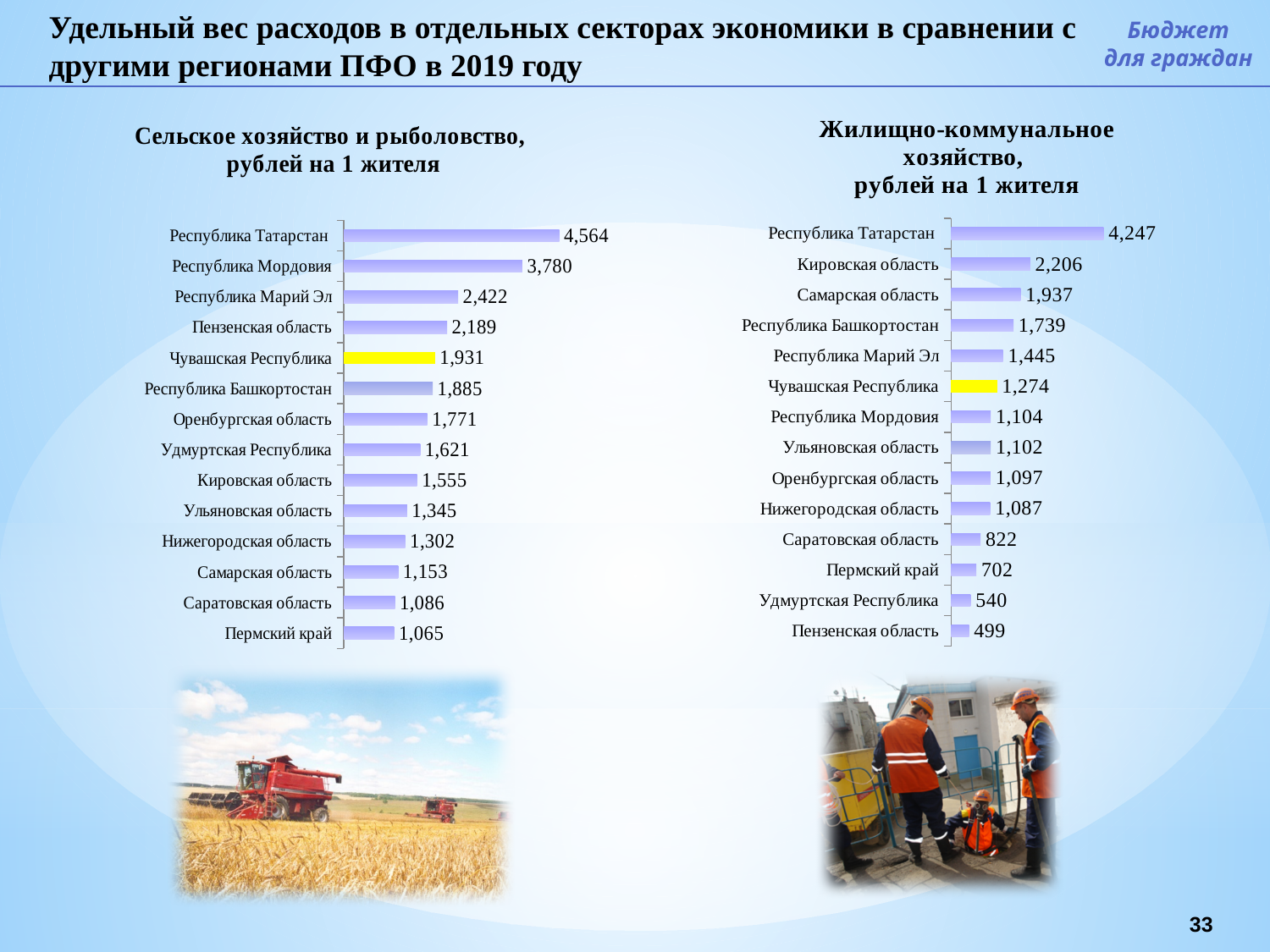
In the chart 'Сельское хозяйство и рыболовство, рублей на 1 жителя', which region has the lowest value? Пермский край In the chart 'Жилищно-коммунальное хозяйство, рублей на 1 жителя', which is larger: Самарская область or Республика Башкортостан? Самарская область How many regions are shown in the chart 'Жилищно-коммунальное хозяйство, рублей на 1 жителя'? 14 In the chart 'Жилищно-коммунальное хозяйство, рублей на 1 жителя', what is the difference between Чувашская Республика and Пензенская область? 775 In the chart 'Жилищно-коммунальное хозяйство, рублей на 1 жителя', which region's bar is highlighted in yellow? Чувашская Республика In the chart 'Жилищно-коммунальное хозяйство, рублей на 1 жителя', which region has the lowest value? Пензенская область What type of chart is 'Сельское хозяйство и рыболовство, рублей на 1 жителя'? Bar chart In the chart 'Сельское хозяйство и рыболовство, рублей на 1 жителя', which region has the highest value? Республика Татарстан In the chart 'Сельское хозяйство и рыболовство, рублей на 1 жителя', which is larger: Пензенская область or Республика Марий Эл? Республика Марий Эл In the chart 'Сельское хозяйство и рыболовство, рублей на 1 жителя', what is the difference between Республика Татарстан and Республика Мордовия? 784 In the chart 'Жилищно-коммунальное хозяйство, рублей на 1 жителя', what is the value for Кировская область? 2,206 In the chart 'Сельское хозяйство и рыболовство, рублей на 1 жителя', what is the value for Чувашская Республика? 1,931